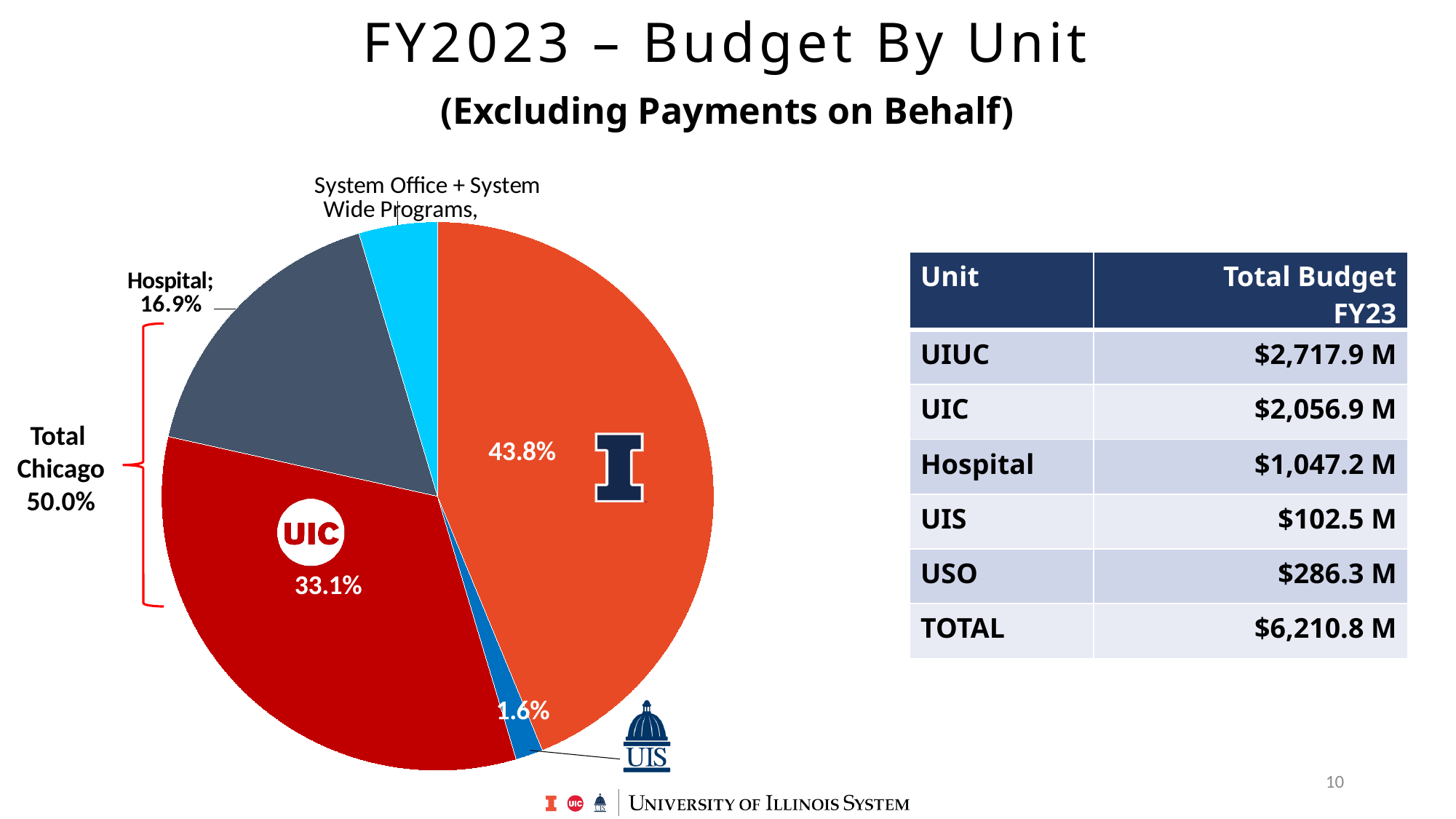
What percentage is shown on the UIC slice of the pie chart? 33.1% What combined share is labelled for Total Chicago by the bracket next to the pie chart? 50.0% Which slice of the pie chart is the largest? the orange slice with the Illinois block I logo (43.8%) What is the title of the slide containing the pie chart? FY2023 – Budget By Unit (Excluding Payments on Behalf) What percentage is shown on the UIS slice of the pie chart? 1.6% What percentage is shown on the orange slice marked with the Illinois block I logo? 43.8% How many slices does the pie chart have? 5 What kind of chart is shown on the slide? pie chart What share of the pie does the Hospital slice represent? 16.9% Which labelled slice of the pie chart is the smallest? UIS (1.6%) Which is larger in the pie chart, the UIC slice or the Hospital slice? UIC By how many percentage points does the UIC slice exceed the Hospital slice? 16.2 percentage points